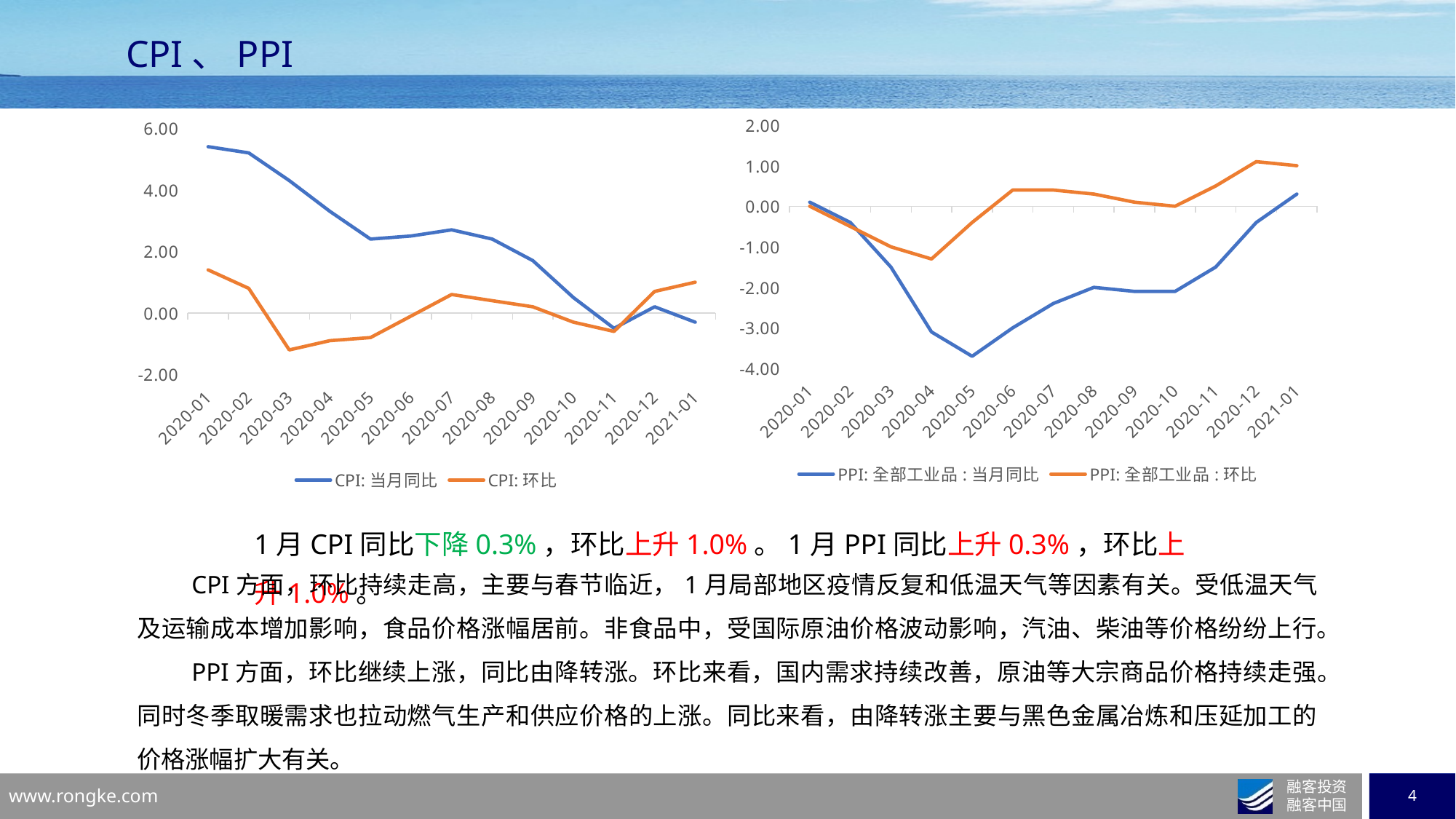
How many series does the legend of the right chart (PPI) list? 2 How many time points are plotted along the x axis of the left chart (CPI)? 13 In the left chart (CPI), is the value for CPI: 当月同比 in 2020-01 greater or less than 4.00? greater In the left chart (CPI), which month has the highest value for CPI: 当月同比? 2020-01 In the left chart (CPI), which month has the lowest value for CPI: 环比? 2020-03 In the right chart (PPI), is the value for PPI: 全部工业品: 当月同比 in 2020-05 greater or less than -3.00? less What kind of chart is the left chart (CPI)? line chart In the right chart (PPI), which month has the lowest value for PPI: 全部工业品: 当月同比? 2020-05 In the left chart (CPI), which series has the larger value in 2020-01, CPI: 当月同比 or CPI: 环比? CPI: 当月同比 In the left chart (CPI), does the CPI: 当月同比 line generally rise or fall from 2020-01 to 2021-01? fall In the right chart (PPI), which series has the larger value in 2020-05, PPI: 全部工业品: 当月同比 or PPI: 全部工业品: 环比? PPI: 全部工业品: 环比 What colour is the line for CPI: 环比 in the left chart? orange